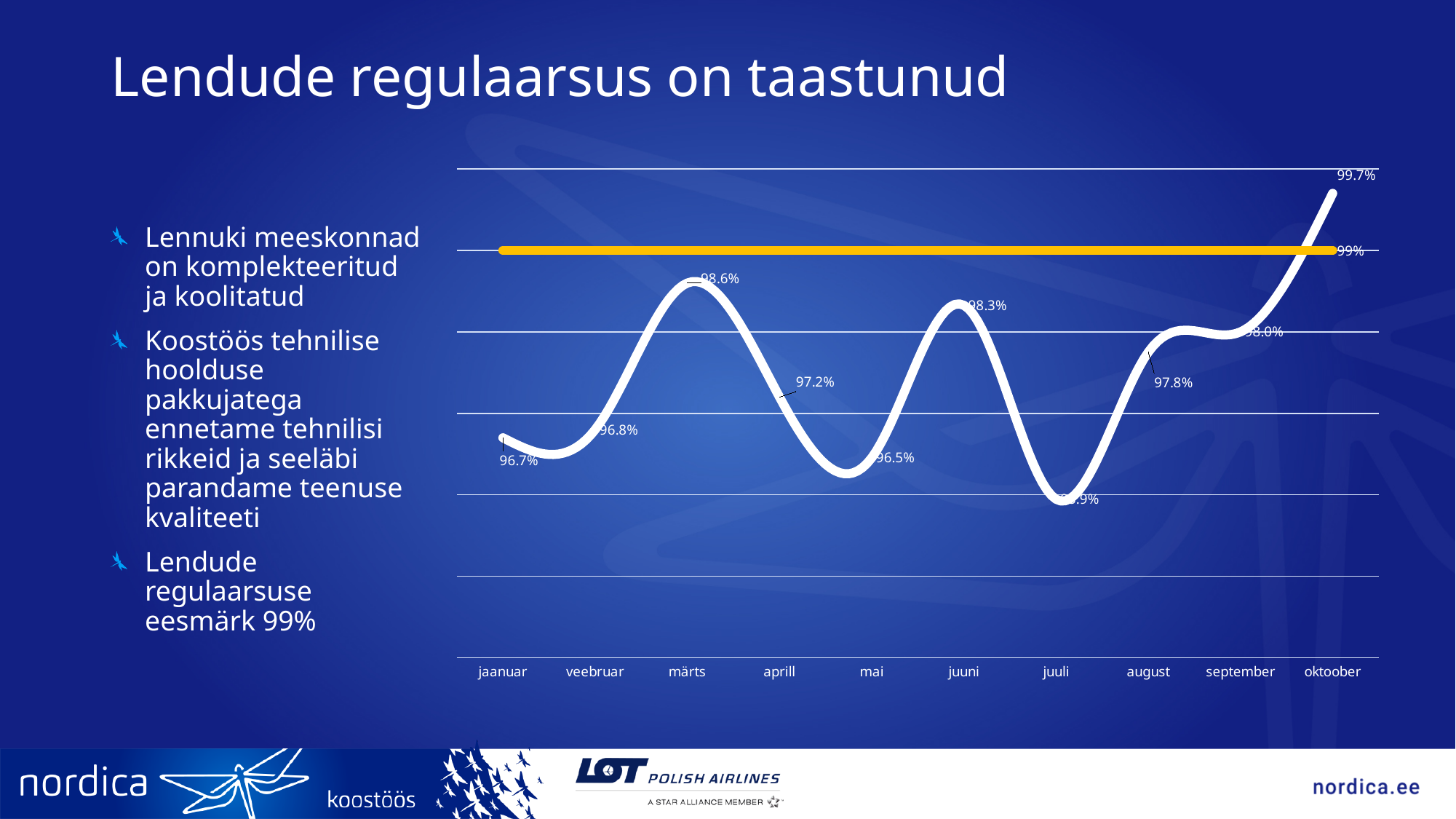
What is the value for märts? 98.6% What is the difference between the values for oktoober and märts? 1.1 percentage points What is the value for jaanuar? 96.7% Is the value for märts greater or less than the 99% target line? less What is the value for oktoober? 99.7% What is the value for mai? 96.5% What kind of chart is shown on the slide? line chart How many months are shown on the x axis? 10 Which is larger, the value for märts or the value for juuni? märts What value does the orange horizontal line mark? 99% Which month has the highest value? oktoober Which month has the lowest value? juuli